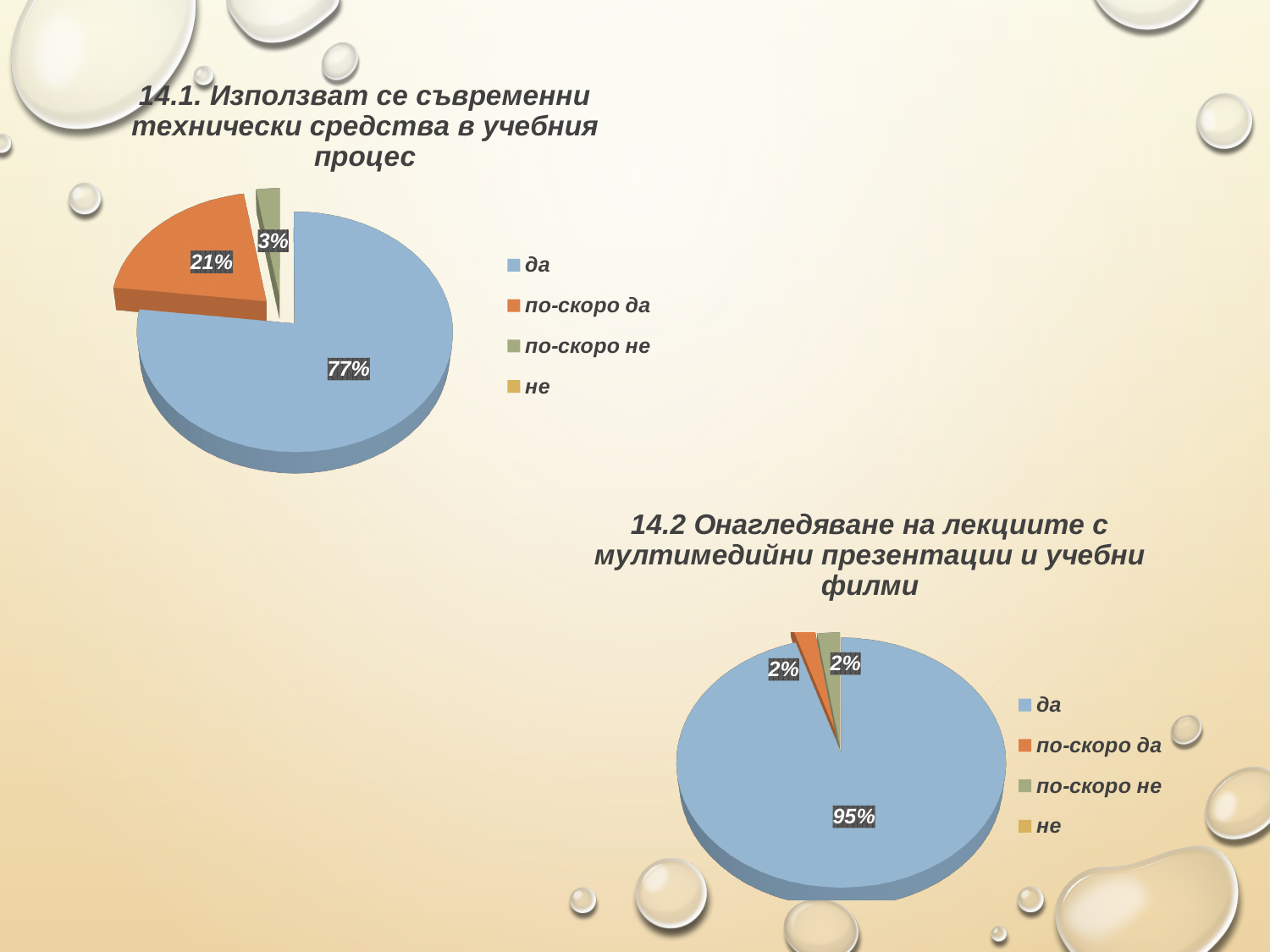
In the chart titled "14.2 Онагледяване на лекциите с мултимедийни презентации и учебни филми", what colour is the "да" slice? Blue In the chart titled "14.1. Използват се съвременни технически средства в учебния процес", what share is labelled for "по-скоро да"? 21% In the chart titled "14.1. Използват се съвременни технически средства в учебния процес", how many entries does the legend list? 4 In the chart titled "14.1. Използват се съвременни технически средства в учебния процес", what is the difference between the "да" and "по-скоро да" shares? 56% In the chart titled "14.2 Онагледяване на лекциите с мултимедийни презентации и учебни филми", what share is labelled for "по-скоро да"? 2% In the chart titled "14.2 Онагледяване на лекциите с мултимедийни презентации и учебни филми", what share is labelled for "да"? 95% In the chart titled "14.1. Използват се съвременни технически средства в учебния процес", what share is labelled for "по-скоро не"? 3% In the chart titled "14.1. Използват се съвременни технически средства в учебния процес", which category has the largest slice? да In the chart titled "14.2 Онагледяване на лекциите с мултимедийни презентации и учебни филми", which category has the largest slice? да Which chart shows a larger share for "да": the chart titled "14.1. Използват се съвременни технически средства в учебния процес" or the chart titled "14.2 Онагледяване на лекциите с мултимедийни презентации и учебни филми"? 14.2 Онагледяване на лекциите с мултимедийни презентации и учебни филми In the chart titled "14.1. Използват се съвременни технически средства в учебния процес", what share is labelled for "да"? 77% What kind of chart is the chart titled "14.2 Онагледяване на лекциите с мултимедийни презентации и учебни филми"? Pie chart